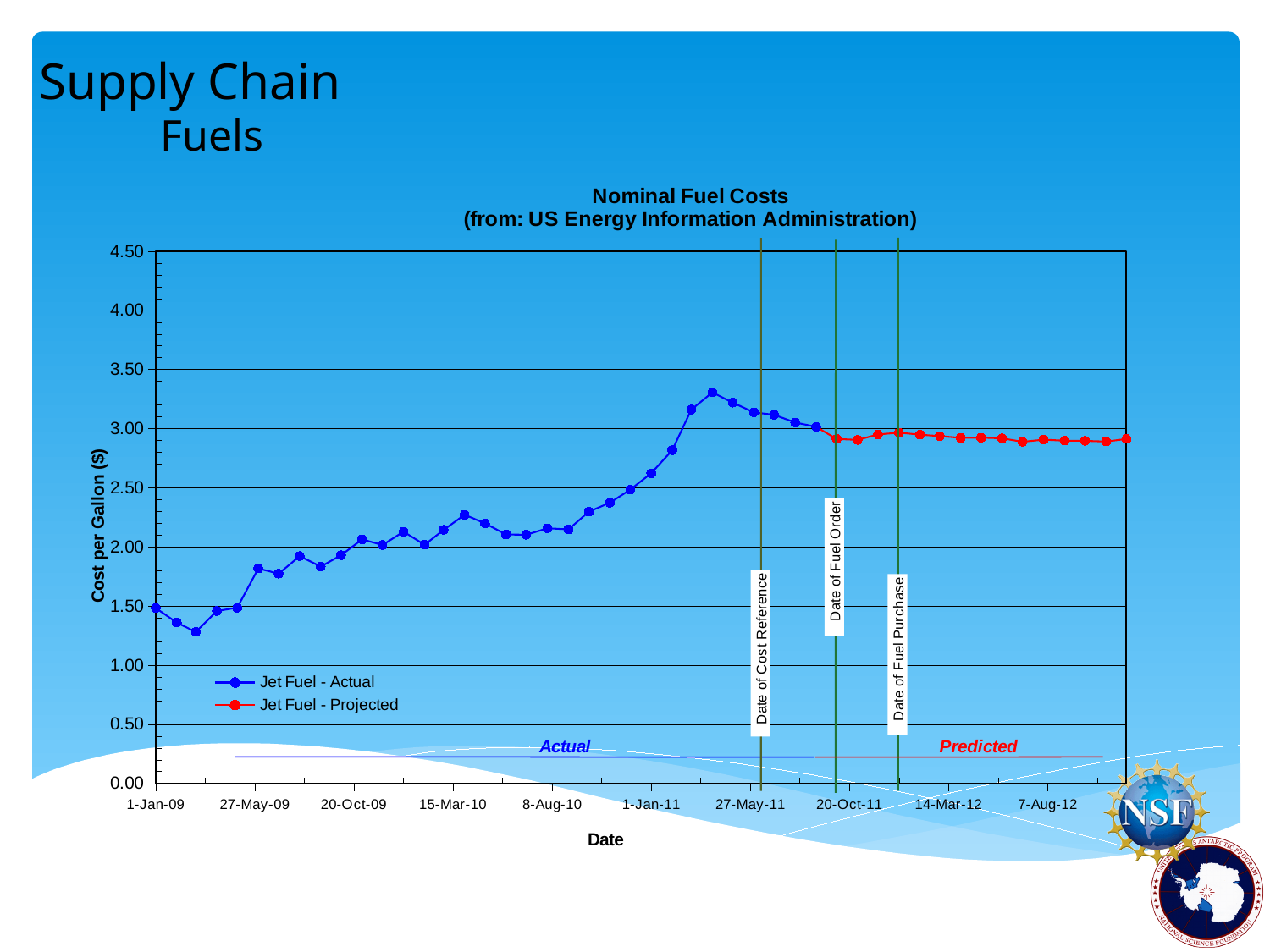
Is the Jet Fuel - Actual value at 1-Jan-09 greater or less than 1.00? greater Which series has the lowest value on the chart, Jet Fuel - Actual or Jet Fuel - Projected? Jet Fuel - Actual Is the Jet Fuel - Actual value at 20-Oct-09 greater or less than 1.50? greater Is the highest Jet Fuel - Actual value greater or less than 3.50? less Does the Jet Fuel - Actual series generally rise or fall from 1-Jan-09 to 1-Jan-11? rise How many series does the legend list? 2 What are the two series named in the legend? Jet Fuel - Actual and Jet Fuel - Projected What is the title of the chart? Nominal Fuel Costs (from: US Energy Information Administration) What kind of chart is shown on the slide? Line chart Which series reaches the higher peak value, Jet Fuel - Actual or Jet Fuel - Projected? Jet Fuel - Actual